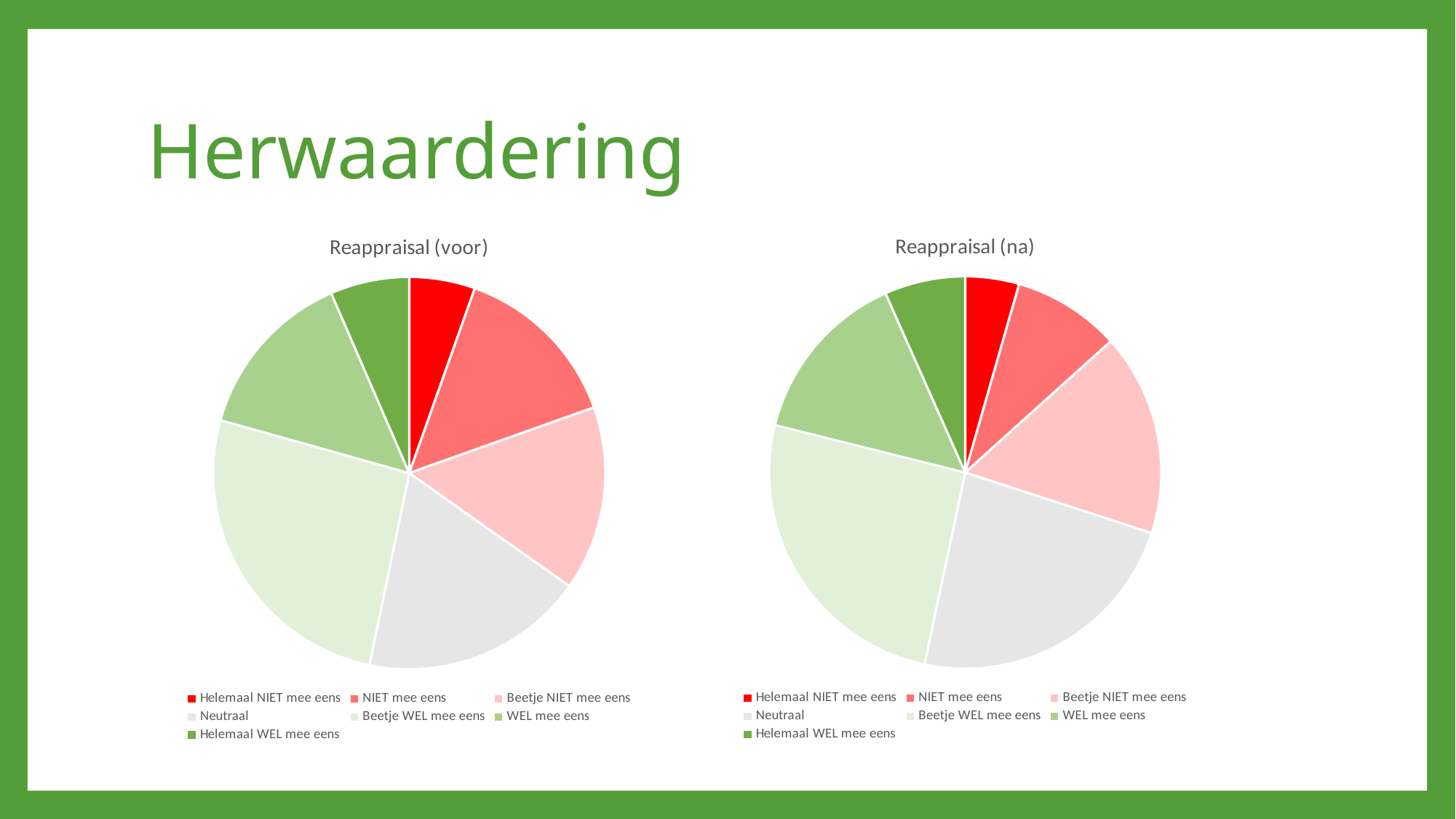
In the "Reappraisal (voor)" chart, what colour is the "Helemaal NIET mee eens" slice? red In the "Reappraisal (voor)" chart, which slice is larger: "Neutraal" or "Helemaal NIET mee eens"? Neutraal What is the title of the pie chart on the right side of the slide? Reappraisal (na) How many slices does the "Reappraisal (na)" pie chart have? 7 In the "Reappraisal (na)" chart, which category has the smallest slice? Helemaal NIET mee eens How many slices does the "Reappraisal (voor)" pie chart have? 7 In the "Reappraisal (na)" chart, which slice is larger: "NIET mee eens" or "Beetje NIET mee eens"? Beetje NIET mee eens In the "Reappraisal (na)" chart, which slice is larger: "WEL mee eens" or "Helemaal WEL mee eens"? WEL mee eens In the "Reappraisal (voor)" chart, which category has the largest slice? Beetje WEL mee eens What kind of chart is the "Reappraisal (na)" chart? pie chart What kind of chart is the "Reappraisal (voor)" chart? pie chart How many entries does the legend of the "Reappraisal (na)" chart list? 7